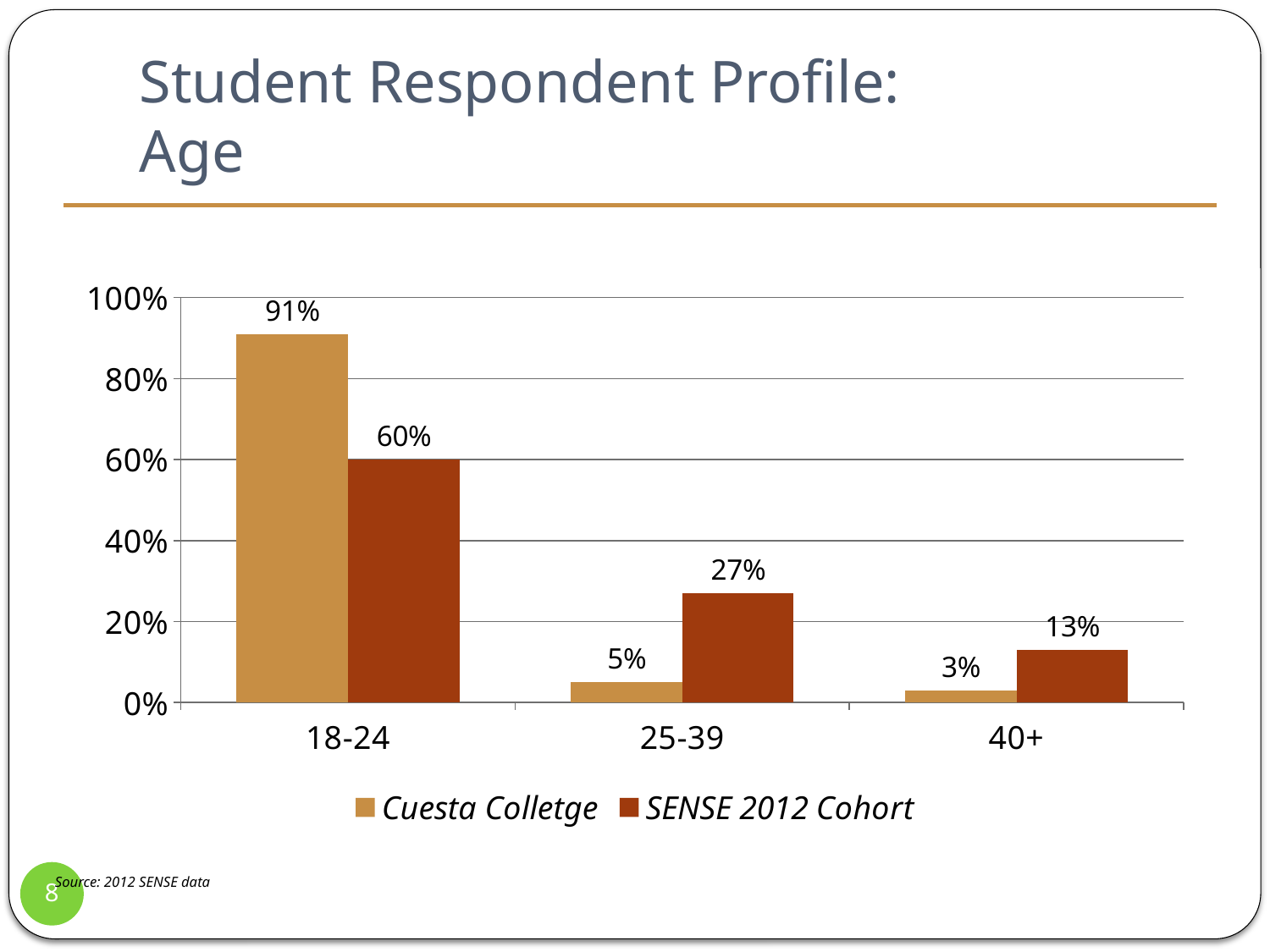
What is the title of the slide? Student Respondent Profile: Age How many age groups are shown on the x axis? 3 For the 25-39 age group, which series has the larger value, Cuesta Colletge or SENSE 2012 Cohort? SENSE 2012 Cohort What is the difference between the Cuesta Colletge and SENSE 2012 Cohort values for the 18-24 age group? 31% Is the SENSE 2012 Cohort value for the 40+ age group greater or less than 20%? less What percentage of Cuesta Colletge respondents are aged 18-24? 91% What kind of chart is shown on the slide? bar chart Which age group has the lowest value for Cuesta Colletge? 40+ How many series does the legend list? 2 Which age group has the highest value for the SENSE 2012 Cohort? 18-24 What is the Cuesta Colletge value for the 40+ age group? 3% What is the SENSE 2012 Cohort value for the 25-39 age group? 27%